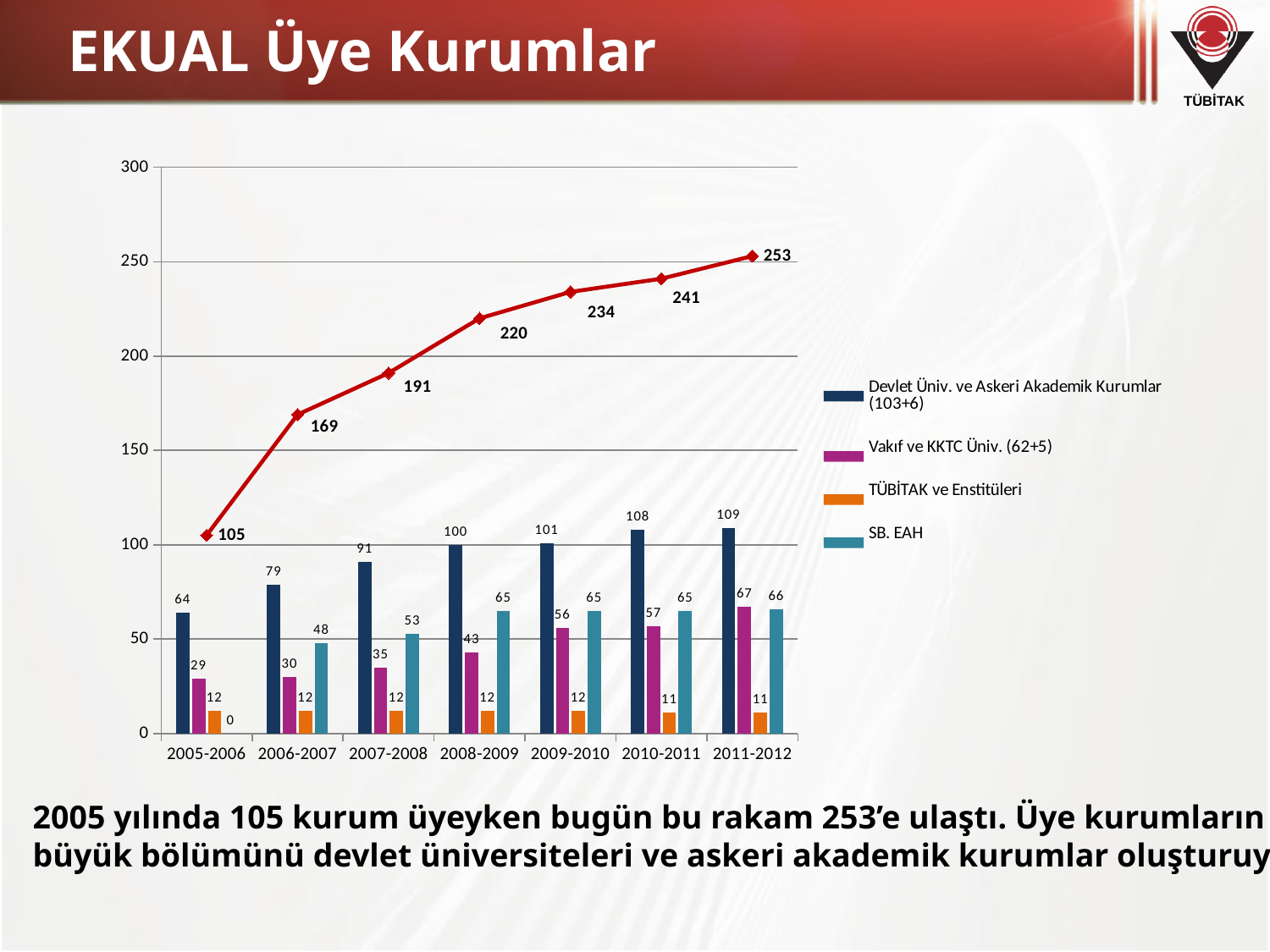
What is the value for Devlet Üniv. ve Askeri Akademik Kurumlar in 2011-2012? 109 How many series does the legend list? 4 What total does the red line show for 2007-2008? 191 What is the value for SB. EAH in 2006-2007? 48 Which is larger in 2009-2010: Vakıf ve KKTC Üniv. or SB. EAH? SB. EAH Does the red line total rise or fall from 2005-2006 to 2011-2012? rise How many periods are shown on the x axis? 7 In which period is the value for SB. EAH lowest? 2005-2006 In which period is the red line total highest? 2011-2012 What is the difference between the red line totals for 2011-2012 and 2005-2006? 148 What colour are the bars for TÜBİTAK ve Enstitüleri? orange What is the value for Vakıf ve KKTC Üniv. in 2008-2009? 43